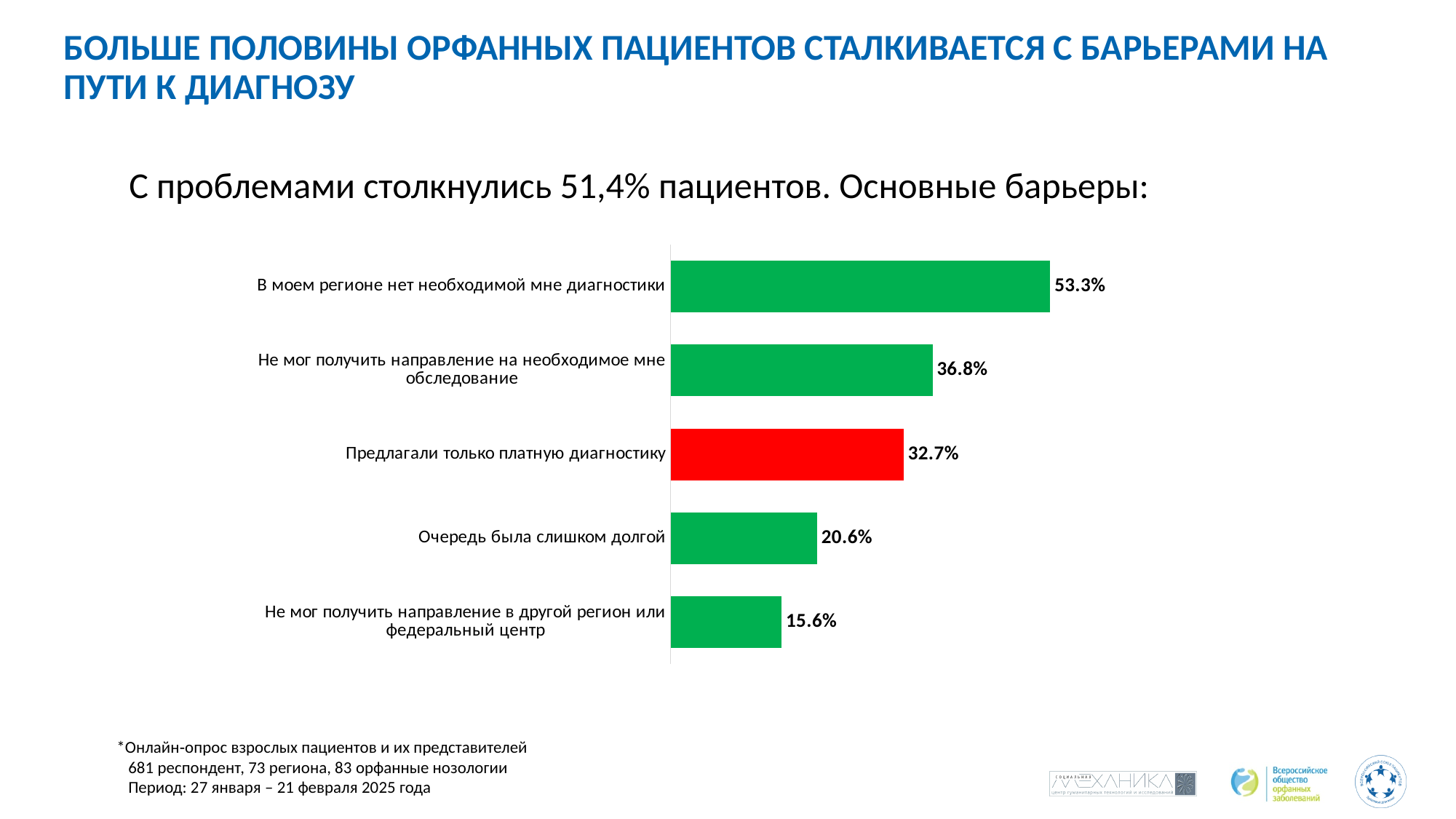
Which is larger: 'Не мог получить направление на необходимое мне обследование' or 'Предлагали только платную диагностику'? Не мог получить направление на необходимое мне обследование What kind of chart is shown on the slide? Bar chart What is the value for 'Предлагали только платную диагностику'? 32.7% Which barrier has the highest value? В моем регионе нет необходимой мне диагностики What is the value for 'Не мог получить направление в другой регион или федеральный центр'? 15.6% What is the difference between 'Очередь была слишком долгой' and 'Не мог получить направление в другой регион или федеральный центр'? 5.0% Which barrier has the lowest value? Не мог получить направление в другой регион или федеральный центр What is the difference between 'В моем регионе нет необходимой мне диагностики' and 'Не мог получить направление на необходимое мне обследование'? 16.5% What is the value for 'Очередь была слишком долгой'? 20.6% What is the value for 'В моем регионе нет необходимой мне диагностики'? 53.3% Which bar is coloured red rather than green? Предлагали только платную диагностику How many barriers (categories) are shown in the chart? 5